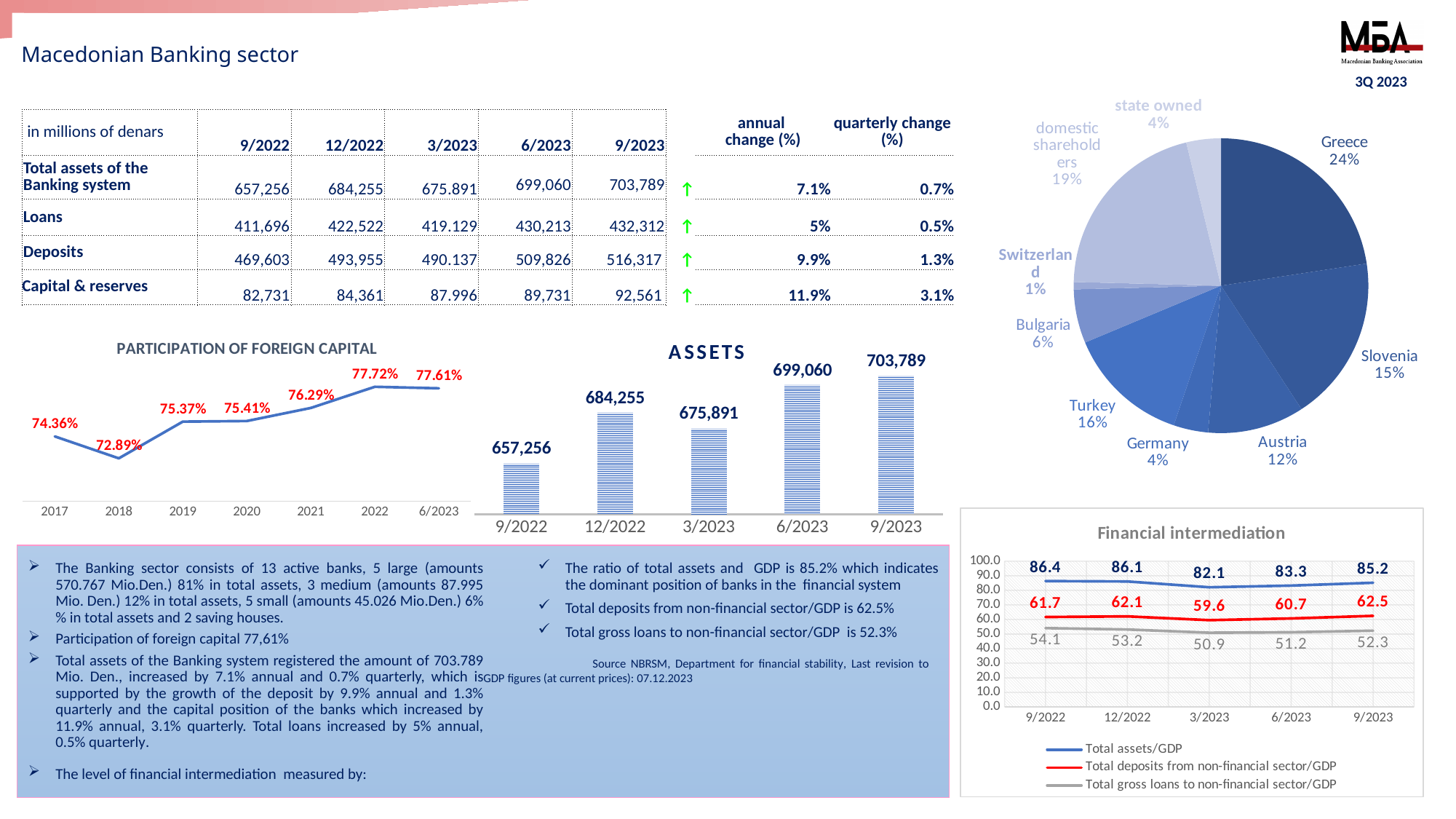
In the pie chart at the top right, which slice is the smallest? Switzerland In the PARTICIPATION OF FOREIGN CAPITAL chart, what is the value for 2018? 72.89% How many series does the legend of the Financial intermediation chart list? 3 In the ASSETS bar chart, what is the difference between the 9/2023 and 9/2022 values? 46,533 In the ASSETS bar chart, what is the value for 9/2023? 703,789 How many data points are plotted in the PARTICIPATION OF FOREIGN CAPITAL chart? 7 What kind of chart is the ASSETS chart? bar chart In the ASSETS bar chart, which period has the lowest value? 9/2022 In the Financial intermediation chart, what is the value of Total gross loans to non-financial sector/GDP for 3/2023? 50.9 In the PARTICIPATION OF FOREIGN CAPITAL chart, which year has the highest value? 2022 In the pie chart at the top right, what share does Greece have? 24%